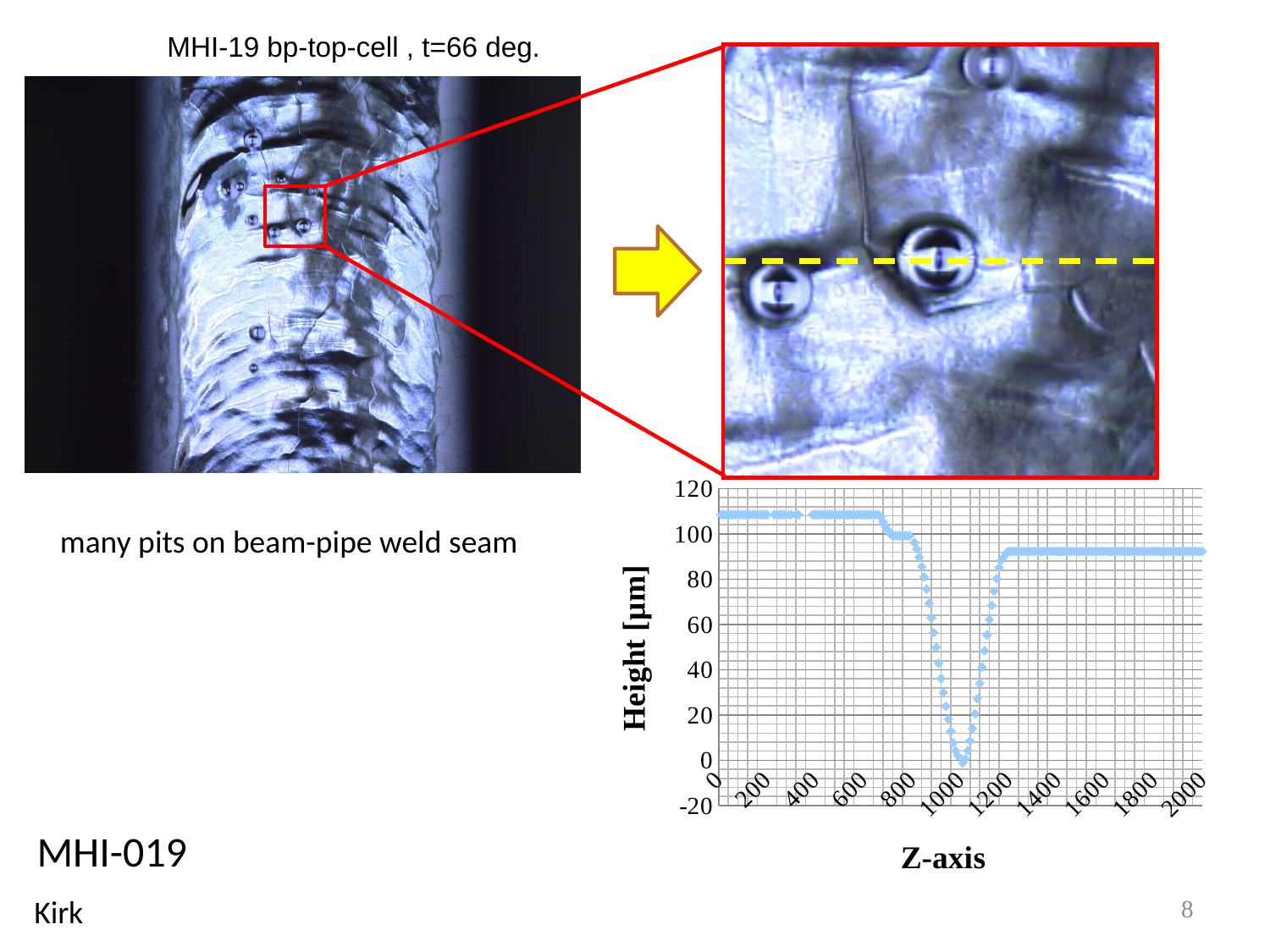
Is the height value at Z = 2000 greater or less than 80? greater What is the label of the horizontal axis of the chart? Z-axis Is the height value at Z = 0 greater or less than 100? greater What kind of chart is shown on the slide? scatter chart Do the height values rise or fall as Z increases from 1050 to 1200? rise What is the label of the vertical axis of the chart? Height [µm] Which has the larger height value: Z = 200 or Z = 2000? Z = 200 Is the height value at Z = 1000 greater or less than 60? less